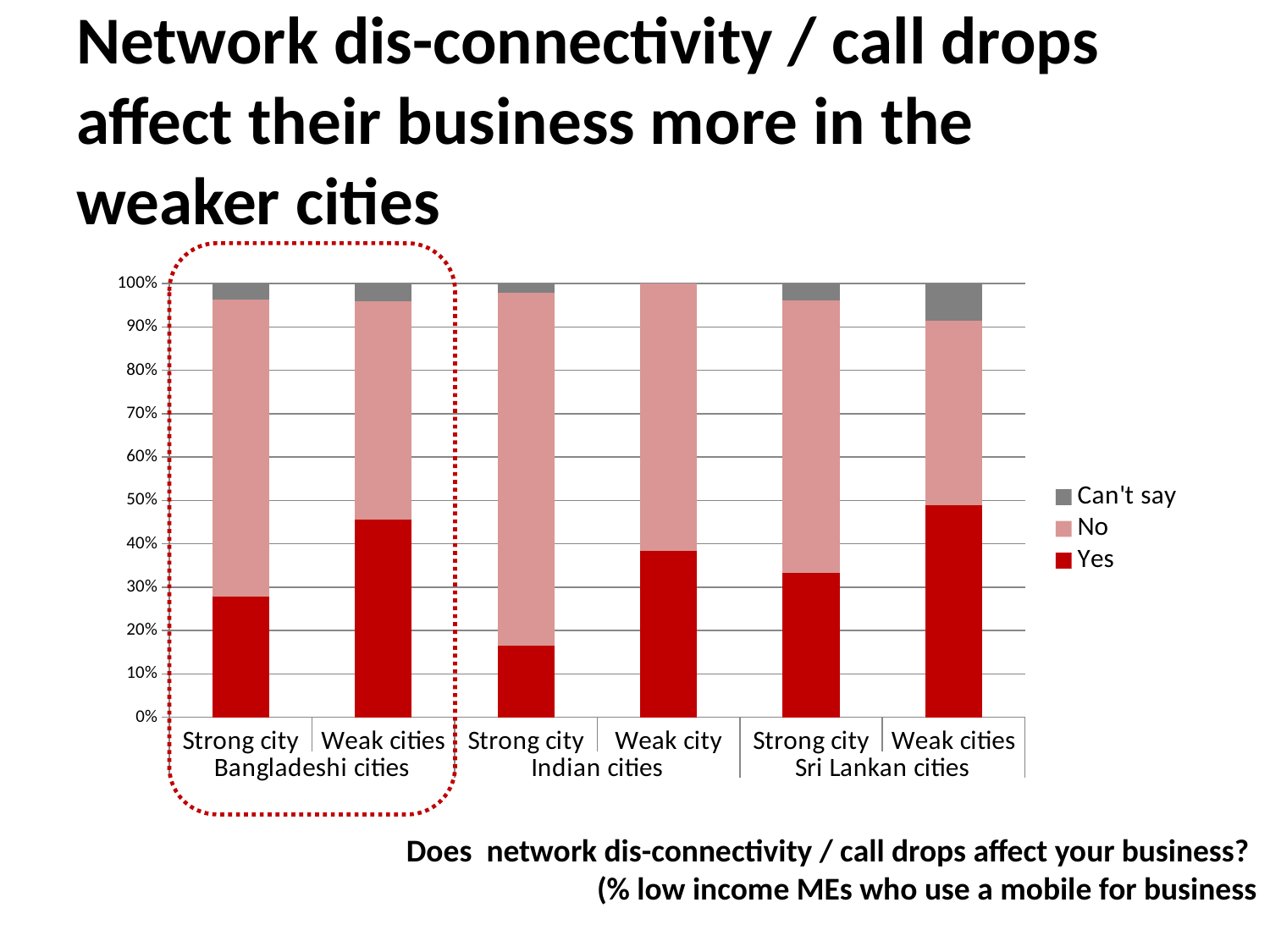
How many bars are plotted in the chart? 6 Is the 'Yes' value for the Indian Strong city greater or less than 20%? less How many series does the legend list? 3 Is the 'Yes' value for the Bangladeshi Strong city greater or less than 40%? less What kind of chart is shown on the slide? Stacked bar chart Among the Bangladeshi cities, which has the larger 'Yes' share: Strong city or Weak cities? Weak cities Is the 'Yes' value for the Indian Weak city greater or less than 30%? greater Which bar has the lowest 'Yes' share? Indian cities – Strong city Which group of cities is enclosed by the red dotted outline? Bangladeshi cities Among the Sri Lankan cities, which has the larger 'Yes' share: Strong city or Weak cities? Weak cities Which bar has the largest 'Can't say' share? Sri Lankan cities – Weak cities